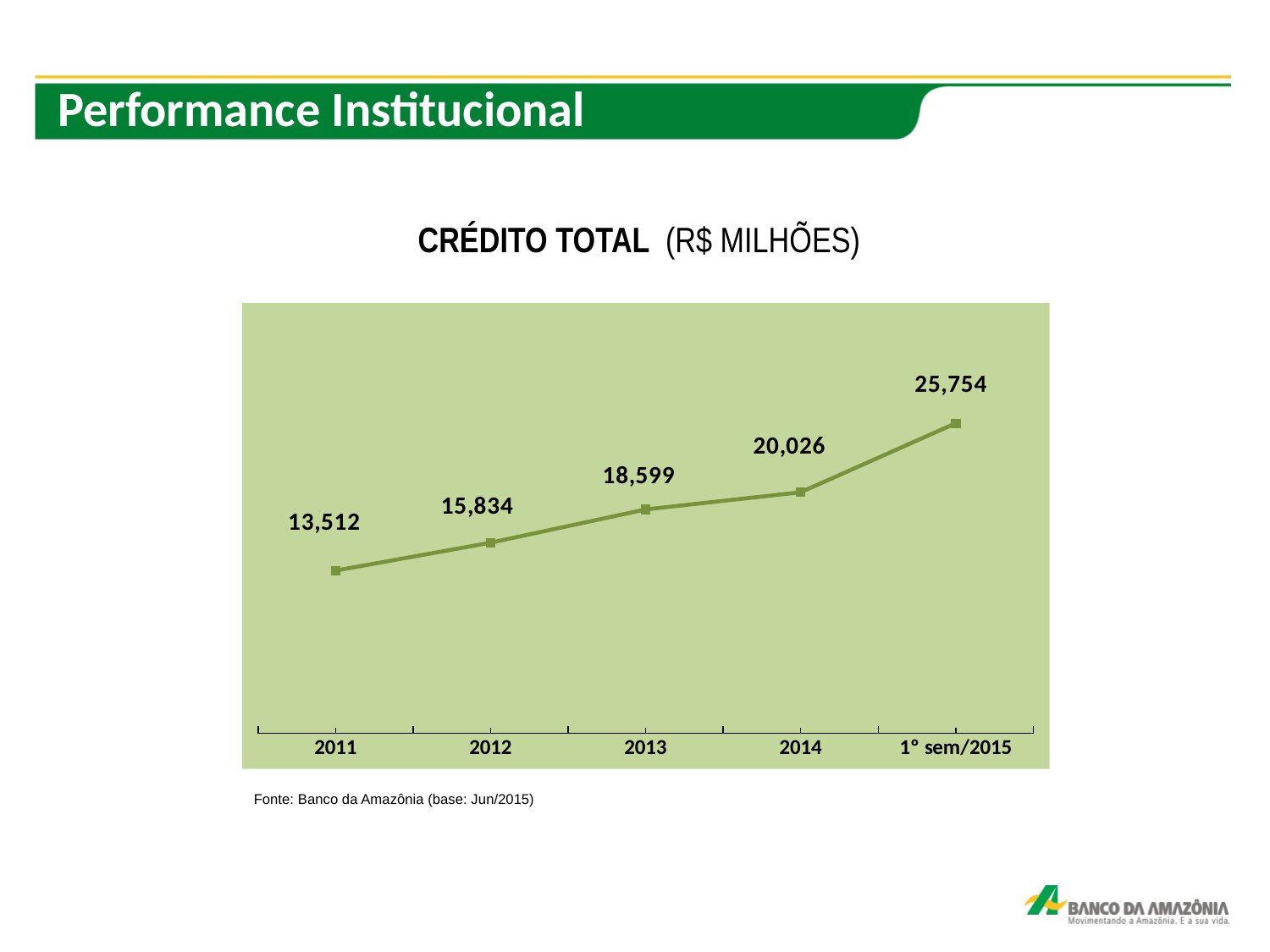
Which is larger, the value for 2012 or the value for 2014? 2014 Which period has the lowest value? 2011 What kind of chart is shown? line chart What is the value for 2013? 18,599 Which period has the highest value? 1° sem/2015 What is the value for 1° sem/2015? 25,754 What is the title of the chart? CRÉDITO TOTAL (R$ MILHÕES) How many data points are plotted on the chart? 5 What is the value for 2011? 13,512 What is the difference between the values for 1° sem/2015 and 2011? 12,242 Do the values rise or fall from 2011 to 1° sem/2015? rise What is the difference between the values for 2014 and 2013? 1,427